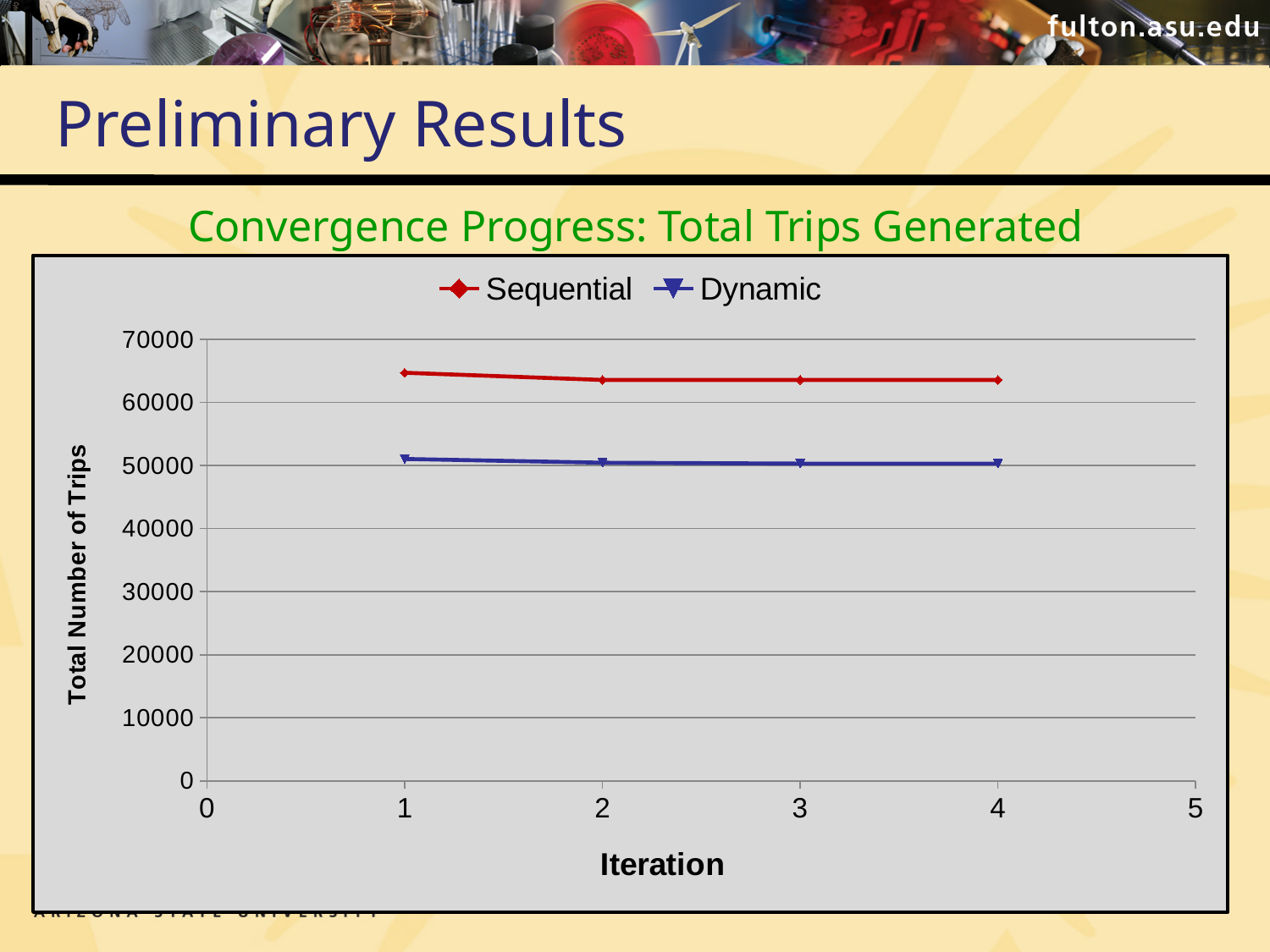
Which series are listed in the legend? Sequential and Dynamic What is the label of the y axis? Total Number of Trips Is the Sequential value at iteration 4 greater or less than 70000? less How many iterations are plotted for each series? 4 Is the Dynamic value at iteration 4 greater or less than 40000? greater What kind of chart is shown on the slide? line chart How many series does the legend list? 2 Is the Sequential value at iteration 1 greater or less than 60000? greater What is the title of the chart? Convergence Progress: Total Trips Generated Does the Sequential series rise or fall from iteration 1 to iteration 2? fall Which series has the higher values, Sequential or Dynamic? Sequential